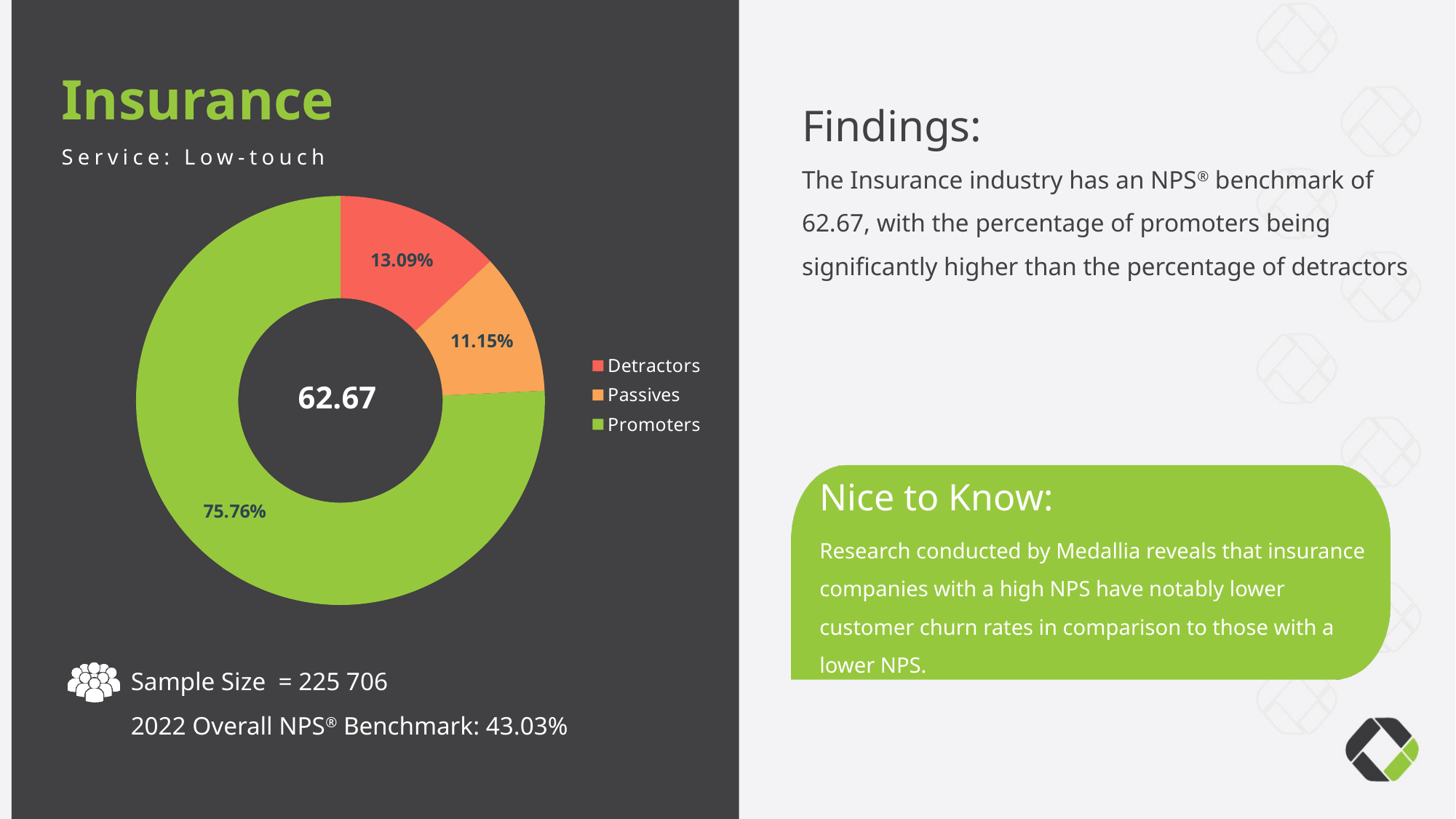
What kind of chart is shown on the slide? Donut (pie) chart What is the difference in percentage points between Detractors and Passives? 1.94 Which category has the largest share of the donut chart? Promoters Which is larger, the Detractors share or the Passives share? Detractors What is the difference in percentage points between Promoters and Detractors? 62.67 Which category has the smallest share of the donut chart? Passives What percentage of the donut chart is Passives? 11.15% What percentage of the donut chart is Detractors? 13.09% What colour represents Promoters in the donut chart? Green What number is displayed in the centre of the donut chart? 62.67 How many categories does the donut chart show? 3 What percentage of the donut chart is Promoters? 75.76%